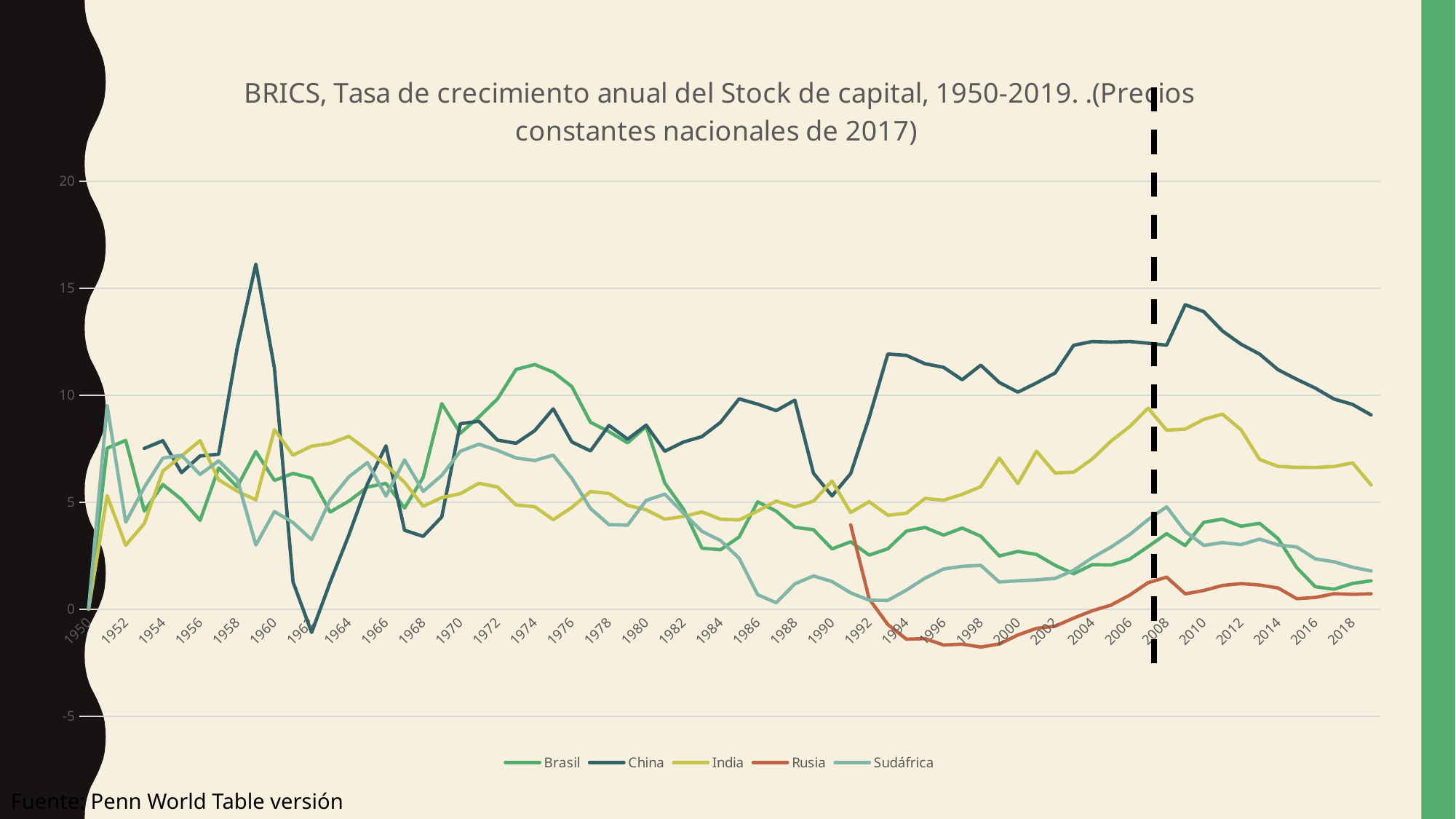
How many series does the legend list? 5 Is the value for Rusia in 1996 greater or less than 0? less What is the title of the chart? BRICS, Tasa de crecimiento anual del Stock de capital, 1950-2019. .(Precios constantes nacionales de 2017) Which countries are listed in the legend? Brasil, China, India, Rusia, Sudáfrica Is the value for Sudáfrica in 1986 greater or less than 5? less What kind of chart is shown on the slide? Line chart Which series has the lowest value in 1996? Rusia Which series has the highest value in 2010? China Is the value for China in 1959 greater or less than 15? greater Does the value for China rise or fall from 2010 to 2018? Fall In 2000, which is larger, the value for China or the value for Brasil? China